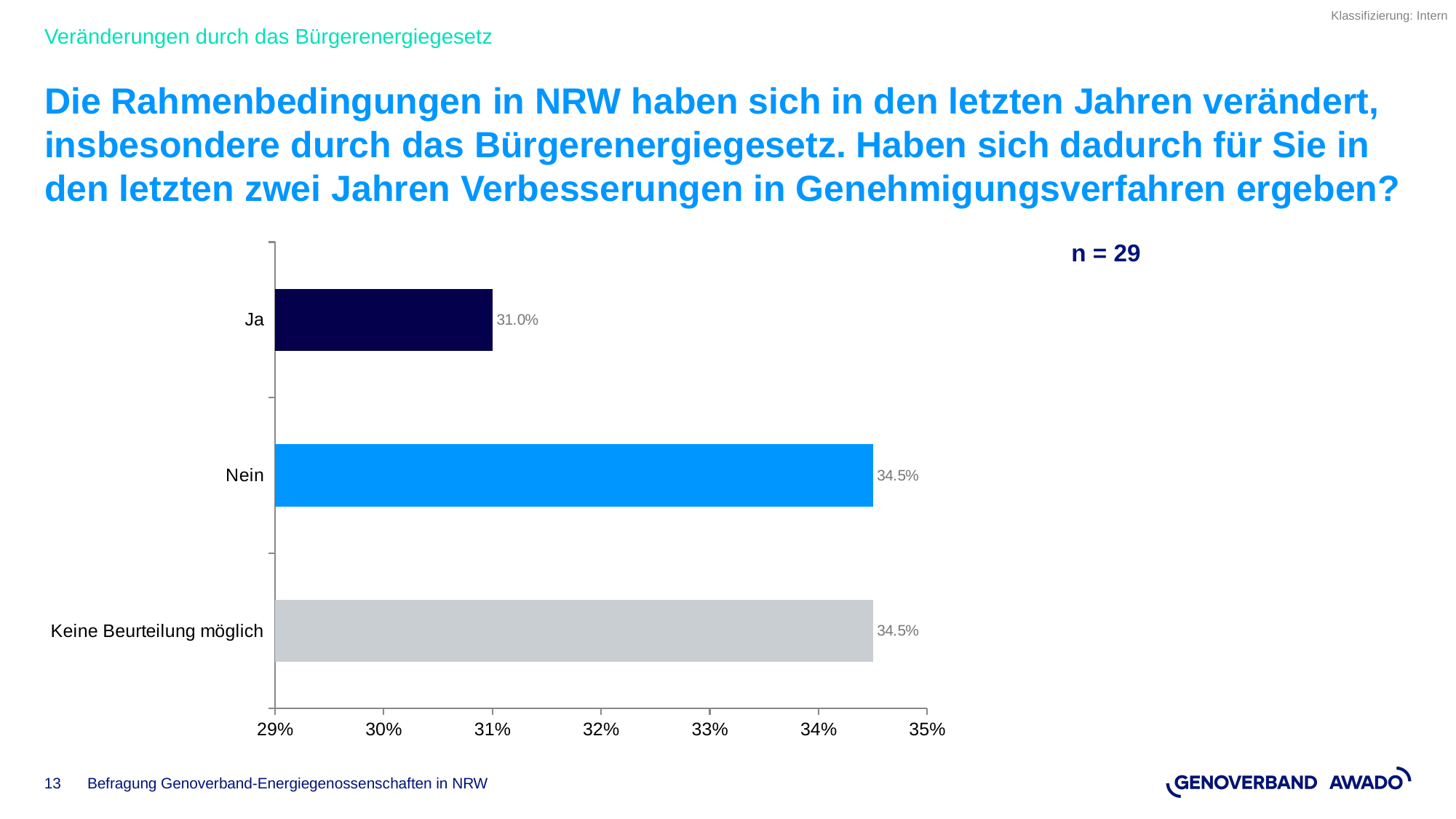
What kind of chart is shown on the slide? bar chart What sample size (n) is stated next to the chart? n = 29 What colour is the bar for "Nein"? light blue How many categories are shown in the chart? 3 Which is larger, the value for "Ja" or the value for "Nein"? Nein What is the value for "Keine Beurteilung möglich"? 34.5% Which category has the lowest value? Ja Is the value for "Keine Beurteilung möglich" greater or less than 33%? greater What is the value for "Nein"? 34.5% Is the value for "Ja" greater or less than 32%? less What is the value for "Ja"? 31.0% What is the difference between the values for "Nein" and "Ja"? 3.5%